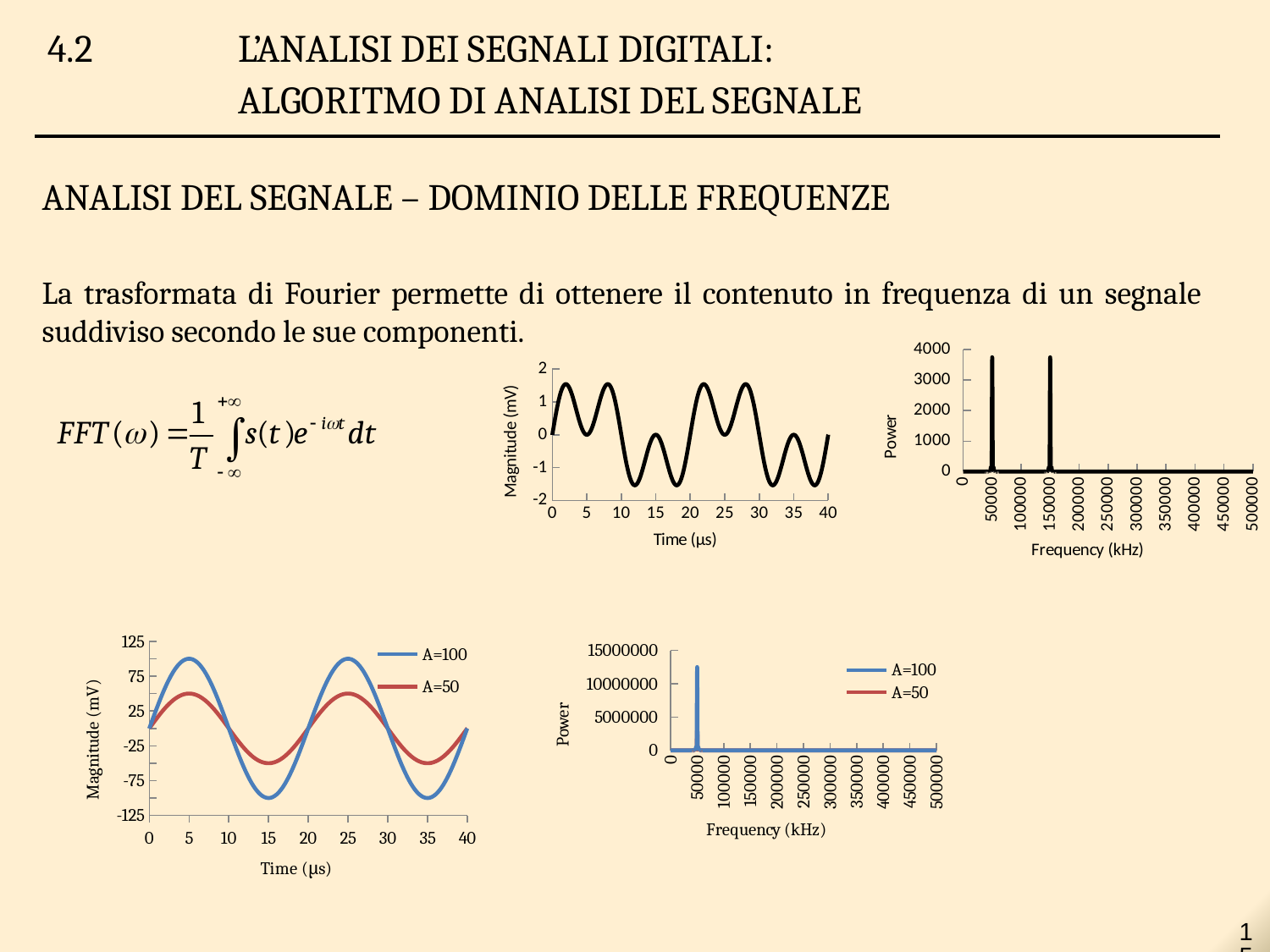
In the top-middle chart, is the maximum magnitude greater or less than 2? less What kind of chart is the top-middle chart (Magnitude vs Time)? line chart In the bottom-right chart (Power vs Frequency), is the peak power greater or less than 10000000? greater In the bottom-right chart (Power vs Frequency), how many series does the legend list? 2 In the top-right chart (Power vs Frequency), is the peak power greater or less than 3000? greater In the top-right chart (Power vs Frequency), how many spikes are visible? 2 In the bottom-left chart (Magnitude vs Time), how many series does the legend list? 2 What is the x-axis label of the bottom-left chart? Time (µs) In the bottom-left chart, which series reaches the higher peak magnitude, A=100 or A=50? A=100 What is the x-axis label of the top-right chart? Frequency (kHz)